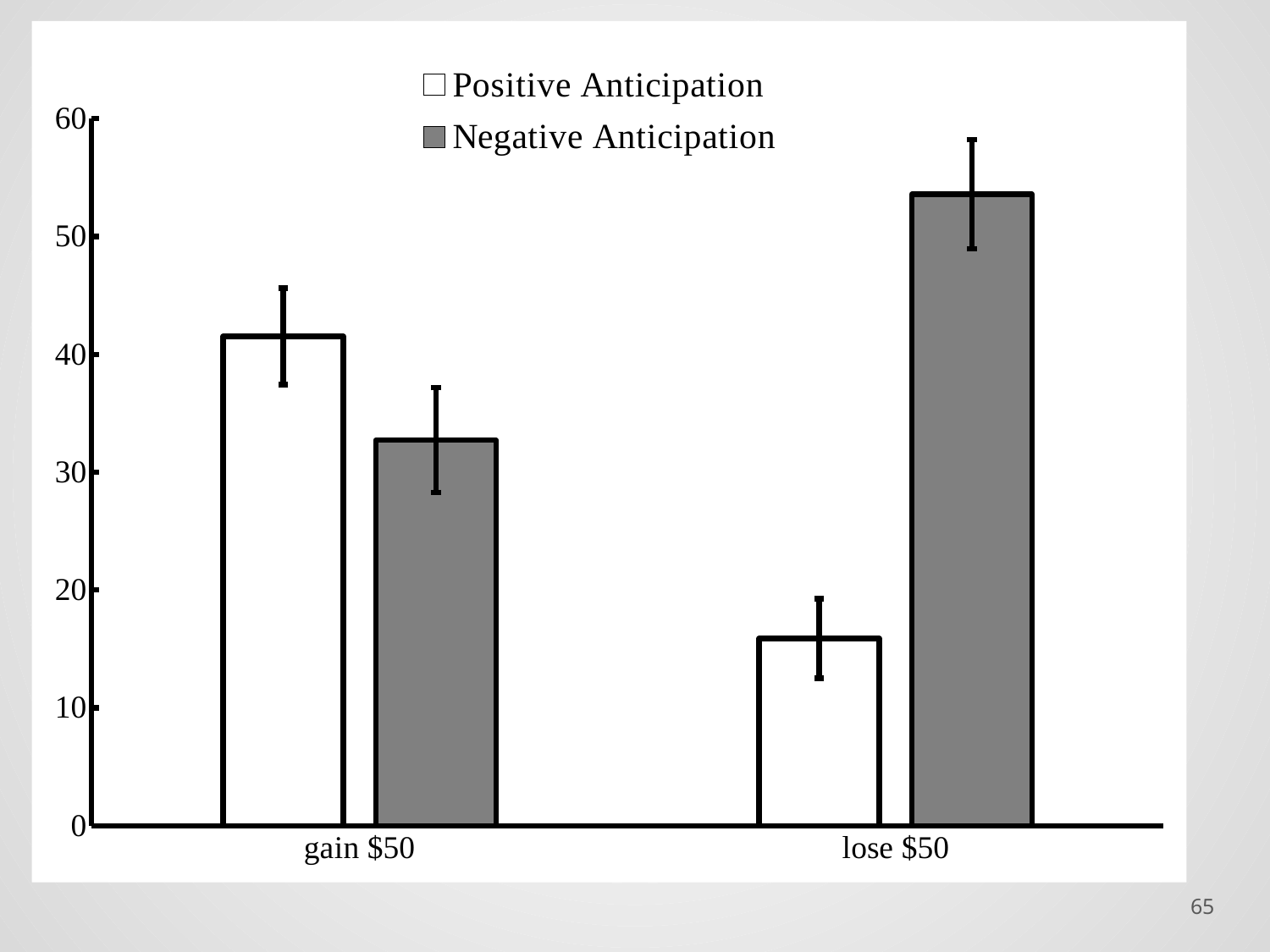
Is the value for Positive Anticipation in the gain $50 condition greater or less than 40? greater In the gain $50 condition, which series has the larger value, Positive Anticipation or Negative Anticipation? Positive Anticipation Which series is shown with grey bars? Negative Anticipation Which bar is the shortest in the chart? Positive Anticipation, lose $50 Is the value for Negative Anticipation in the gain $50 condition greater or less than 30? greater How many series does the legend list? 2 Which bar is the tallest in the chart? Negative Anticipation, lose $50 How many categories are shown on the x axis? 2 What kind of chart is shown on the slide? bar chart Is the value for Negative Anticipation in the lose $50 condition greater or less than 50? greater Which series is shown with white bars? Positive Anticipation